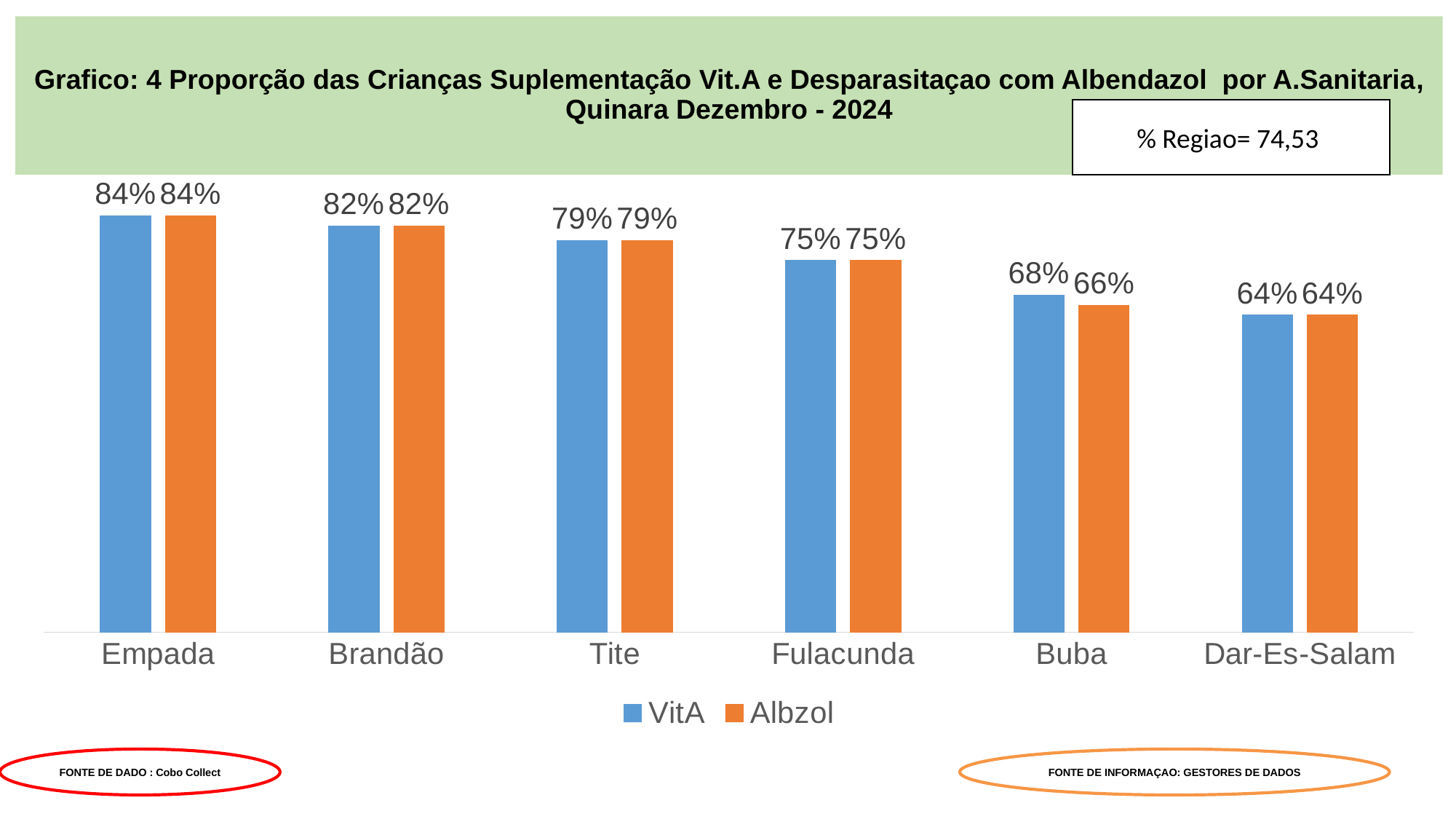
What kind of chart is shown on the slide? bar chart Which category has the lowest Albzol value? Dar-Es-Salam Which is larger, the VitA value for Brandão or the VitA value for Tite? Brandão What is the VitA value for Empada? 84% What is the VitA value for Fulacunda? 75% Which category has the highest VitA value? Empada What is the Albzol value for Buba? 66% What is the difference between the VitA value for Empada and the VitA value for Dar-Es-Salam? 20% What is the difference between the VitA and Albzol values for Buba? 2% How many series does the legend list? 2 Do the VitA values rise or fall from Empada to Dar-Es-Salam along the x axis? fall How many categories are shown on the x axis? 6